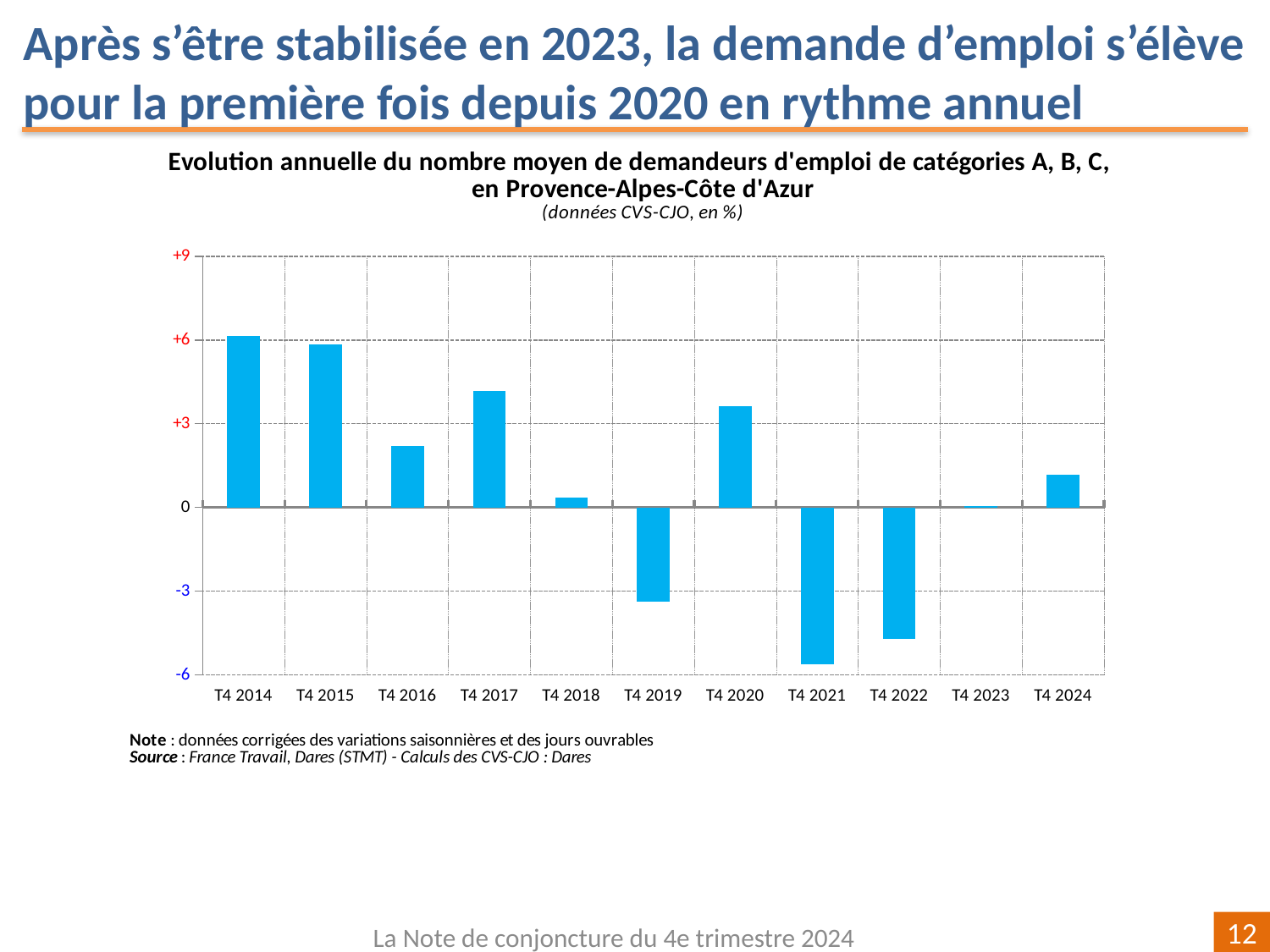
Which is larger, the value for T4 2017 or the value for T4 2016? T4 2017 How many quarters (categories) are plotted on the x axis? 11 Is the value for T4 2016 greater or less than +3? less Which is larger, the value for T4 2020 or the value for T4 2024? T4 2020 Which quarter has the lowest (most negative) value? T4 2021 In what unit are the data expressed, according to the chart subtitle? en % Is the value for T4 2017 greater or less than +3? greater Is the value for T4 2022 greater or less than -6? greater What kind of chart is shown on the slide? Bar chart How many bars exceed +3? 4